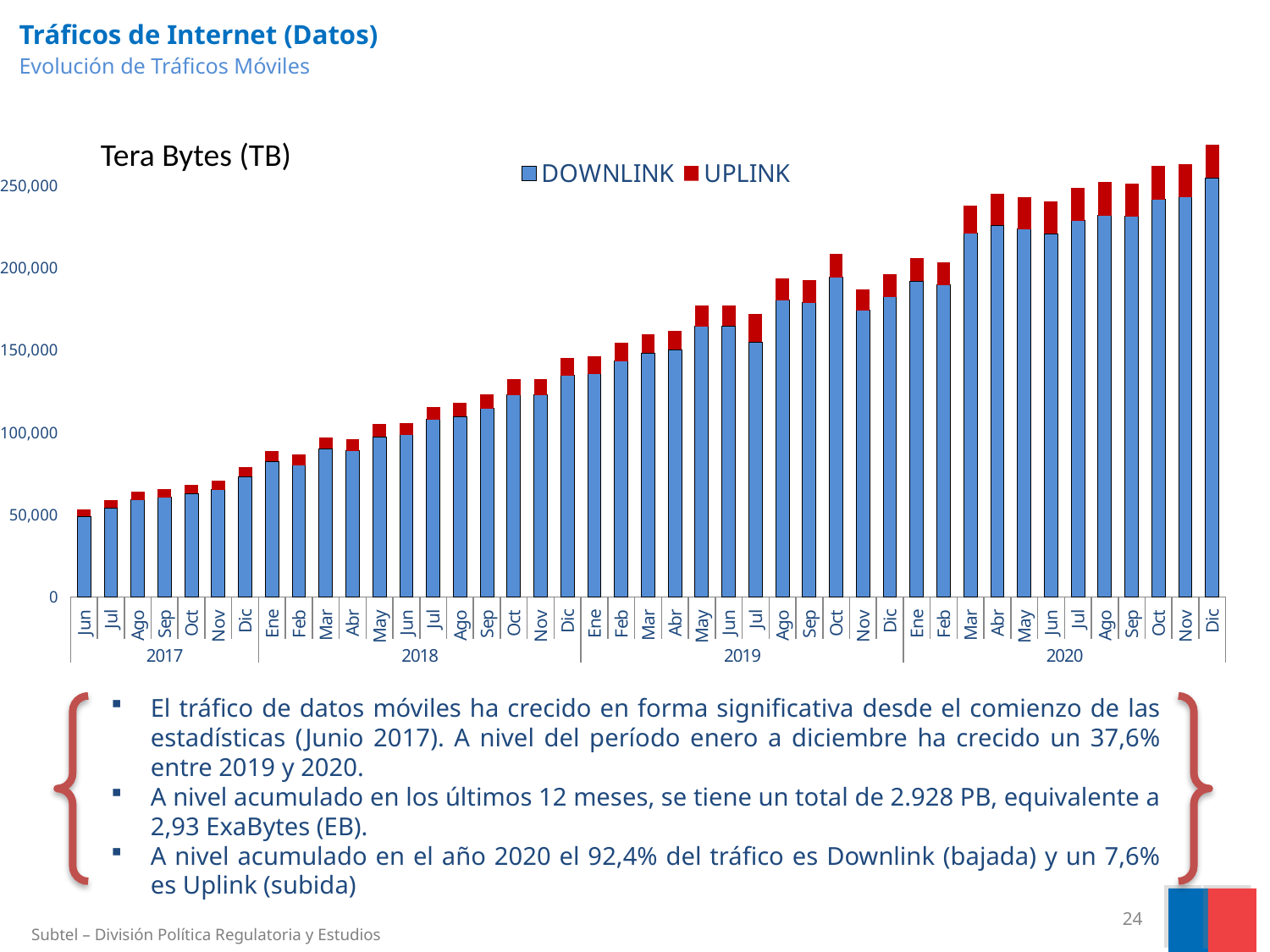
Do the total traffic values generally rise or fall from Jun 2017 to Dic 2020? Rise What unit is indicated above the y axis of the chart? Tera Bytes (TB) Which two series are shown in the chart legend? DOWNLINK and UPLINK Is the total traffic for Ene 2018 greater or less than 100,000? less How many monthly bars are plotted in the chart? 43 How many series does the chart legend list? 2 Is the total traffic for Dic 2020 greater or less than 250,000? greater Which month has the larger total traffic, Oct 2019 or Nov 2019? Oct 2019 What kind of chart is shown on the slide? Stacked bar chart Which month has the highest total traffic in the chart? Dic 2020 Is the total traffic for Nov 2019 greater or less than 200,000? less Which month has the lowest total traffic in the chart? Jun 2017